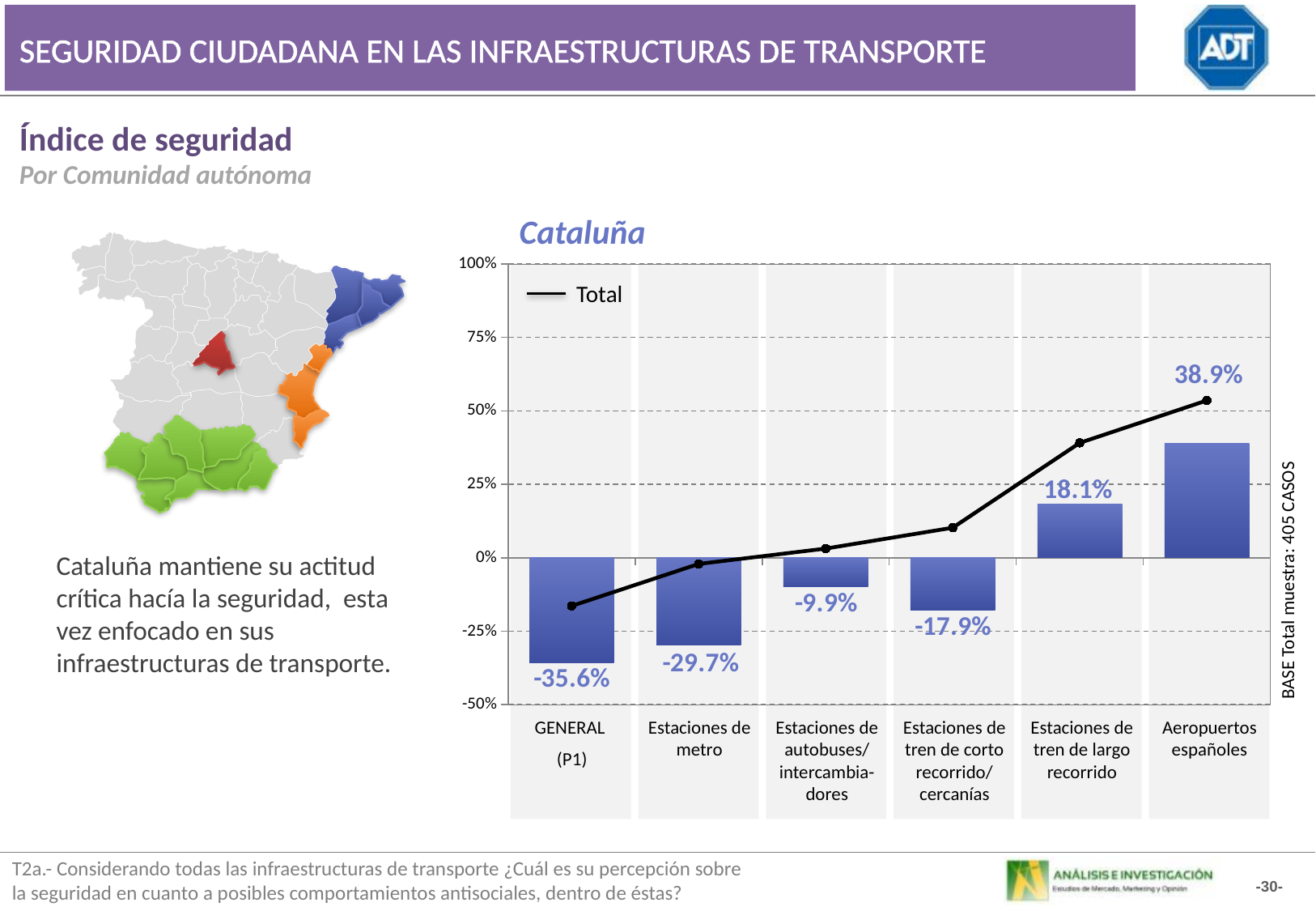
What is the value for Aeropuertos españoles in the Cataluña chart? 38.9% What is the value for GENERAL (P1) in the Cataluña chart? -35.6% Which category has the lowest bar value in the Cataluña chart? GENERAL (P1) What is the value for Estaciones de tren de corto recorrido/cercanías in the Cataluña chart? -17.9% Which has a higher bar value in the Cataluña chart, Estaciones de autobuses/intercambiadores or Estaciones de tren de corto recorrido/cercanías? Estaciones de autobuses/intercambiadores How many series does the legend of the Cataluña chart list? 1 What is the value for Estaciones de metro in the Cataluña chart? -29.7% How many categories are shown on the x axis of the Cataluña chart? 6 Which category has the highest bar value in the Cataluña chart? Aeropuertos españoles What is the difference between the values for Aeropuertos españoles and Estaciones de tren de largo recorrido in the Cataluña chart? 20.8 percentage points Is the Total line value for Aeropuertos españoles greater or less than 50%? greater